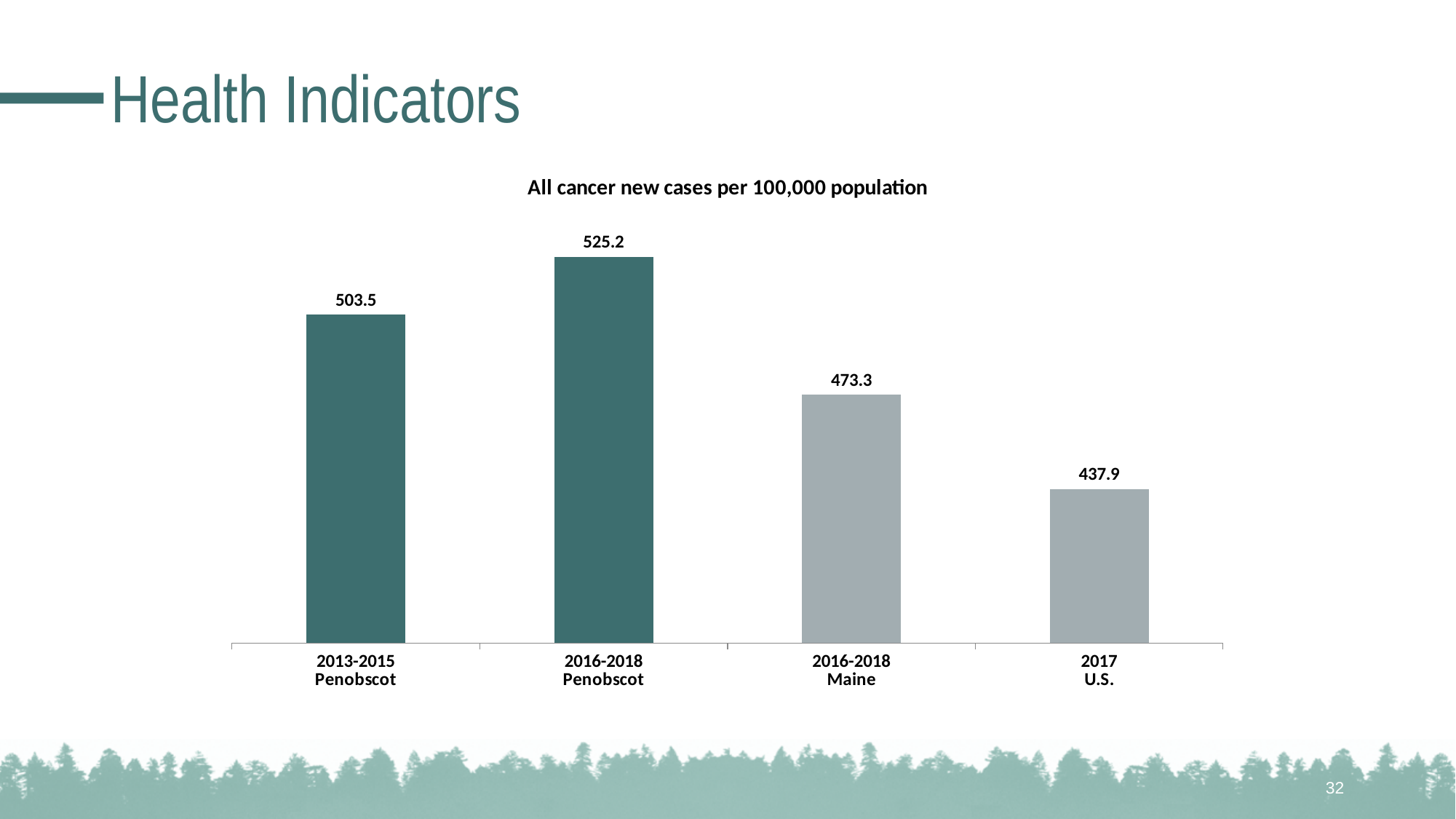
What is the value for 2016-2018 Maine? 473.3 Which category has the lowest value? 2017 U.S. Which category has the highest value? 2016-2018 Penobscot What is the value for 2013-2015 Penobscot? 503.5 What is the value for 2017 U.S.? 437.9 What is the difference between 2016-2018 Penobscot and 2016-2018 Maine? 51.9 What kind of chart is shown on the slide? Bar chart What is the value for 2016-2018 Penobscot? 525.2 Which is larger, the value for 2016-2018 Maine or the value for 2017 U.S.? 2016-2018 Maine How many bars are shown in the chart? 4 What is the title of the chart? All cancer new cases per 100,000 population What is the difference between 2016-2018 Penobscot and 2013-2015 Penobscot? 21.7